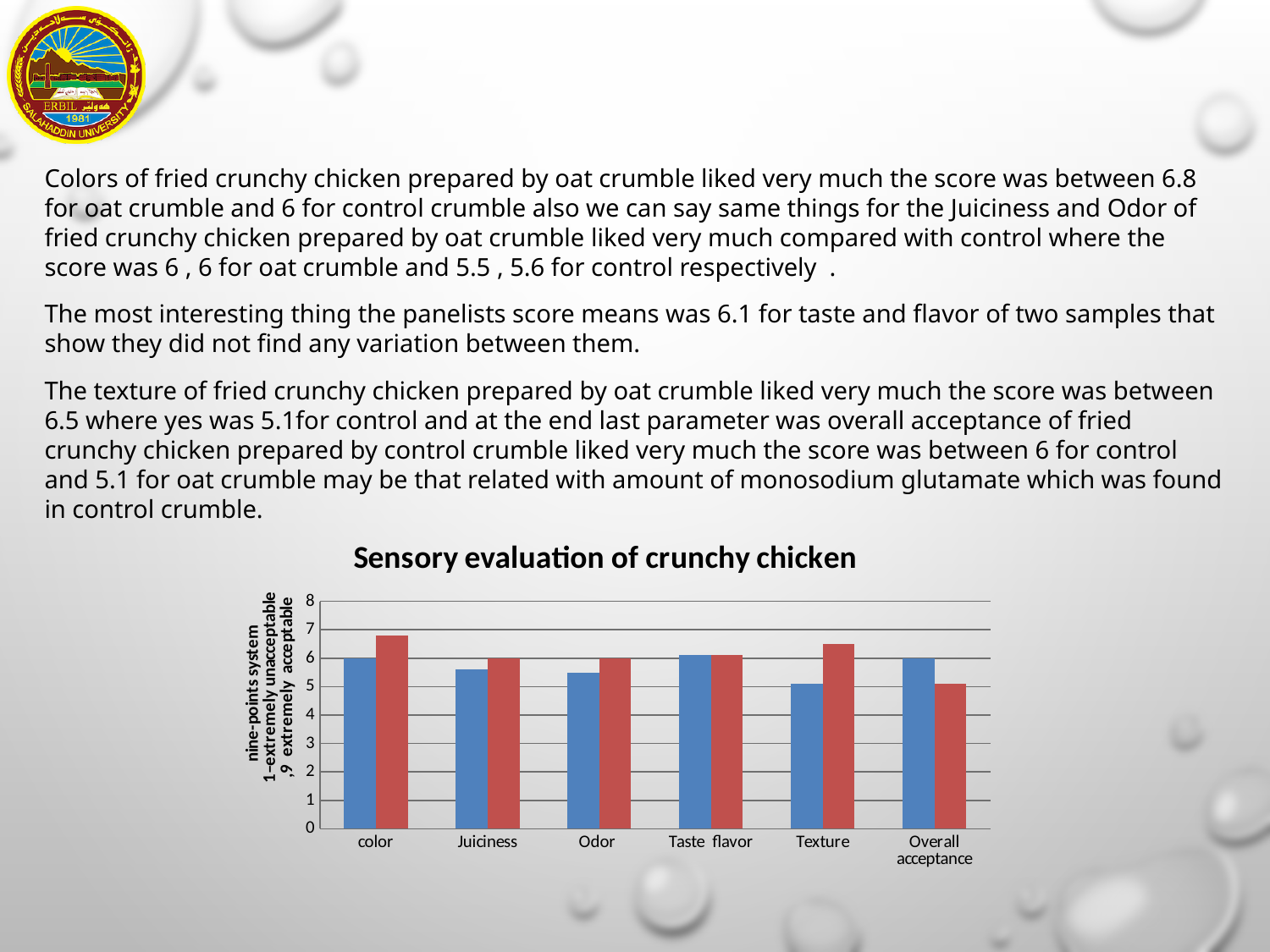
Is the value of the red bar for Texture greater or less than 6? greater Is the value of the blue bar for Texture greater or less than 6? less For the Overall acceptance category, which bar is taller, the blue one or the red one? blue What is the highest value shown on the vertical axis of the chart? 8 What kind of chart is shown on the slide? bar chart Is the value of the red bar for Overall acceptance greater or less than 6? less For the color category, which bar is taller, the blue one or the red one? red How many categories are shown on the x axis of the chart? 6 Among the red bars, which category has the highest value? color What is the value of the blue bar for color? 6 What is the title of the chart? Sensory evaluation of crunchy chicken